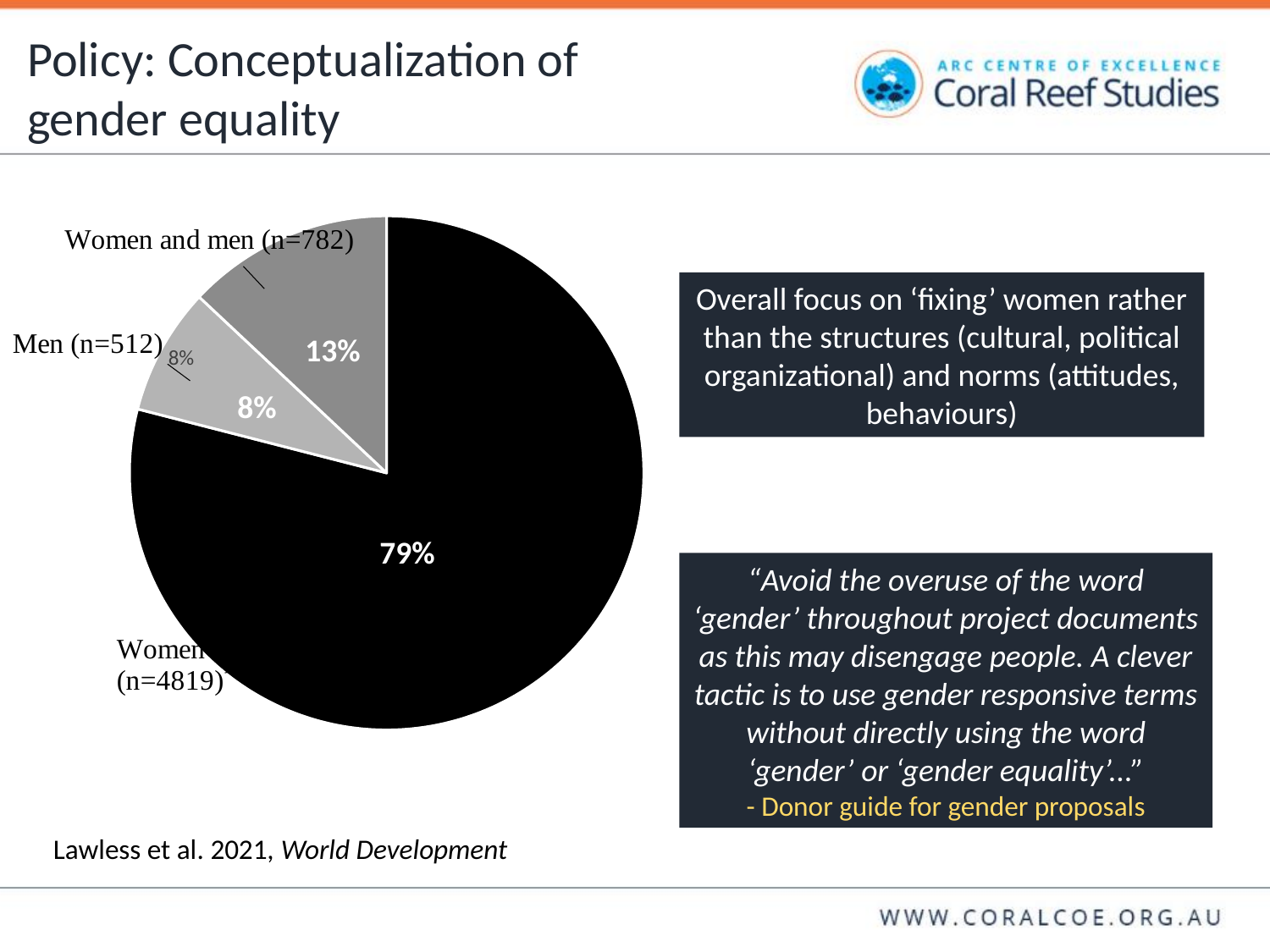
What percentage of the pie is the Women (n=4819) slice? 79% Which slice is larger, Men (n=512) or Women and men (n=782)? Women and men (n=782) What is the difference in percentage points between the Women (n=4819) slice and the Women and men (n=782) slice? 66 What colour is the largest slice of the pie chart? black What percentage of the pie is the Men (n=512) slice? 8% What is the sample size (n) shown for the Women and men category? 782 What kind of chart is shown on the slide? pie chart Which slice of the pie chart is the largest? Women (n=4819) Which slice of the pie chart is the smallest? Men (n=512) What is the difference in percentage points between the Women and men (n=782) slice and the Men (n=512) slice? 5 How many slices does the pie chart have? 3 What percentage of the pie is the Women and men (n=782) slice? 13%